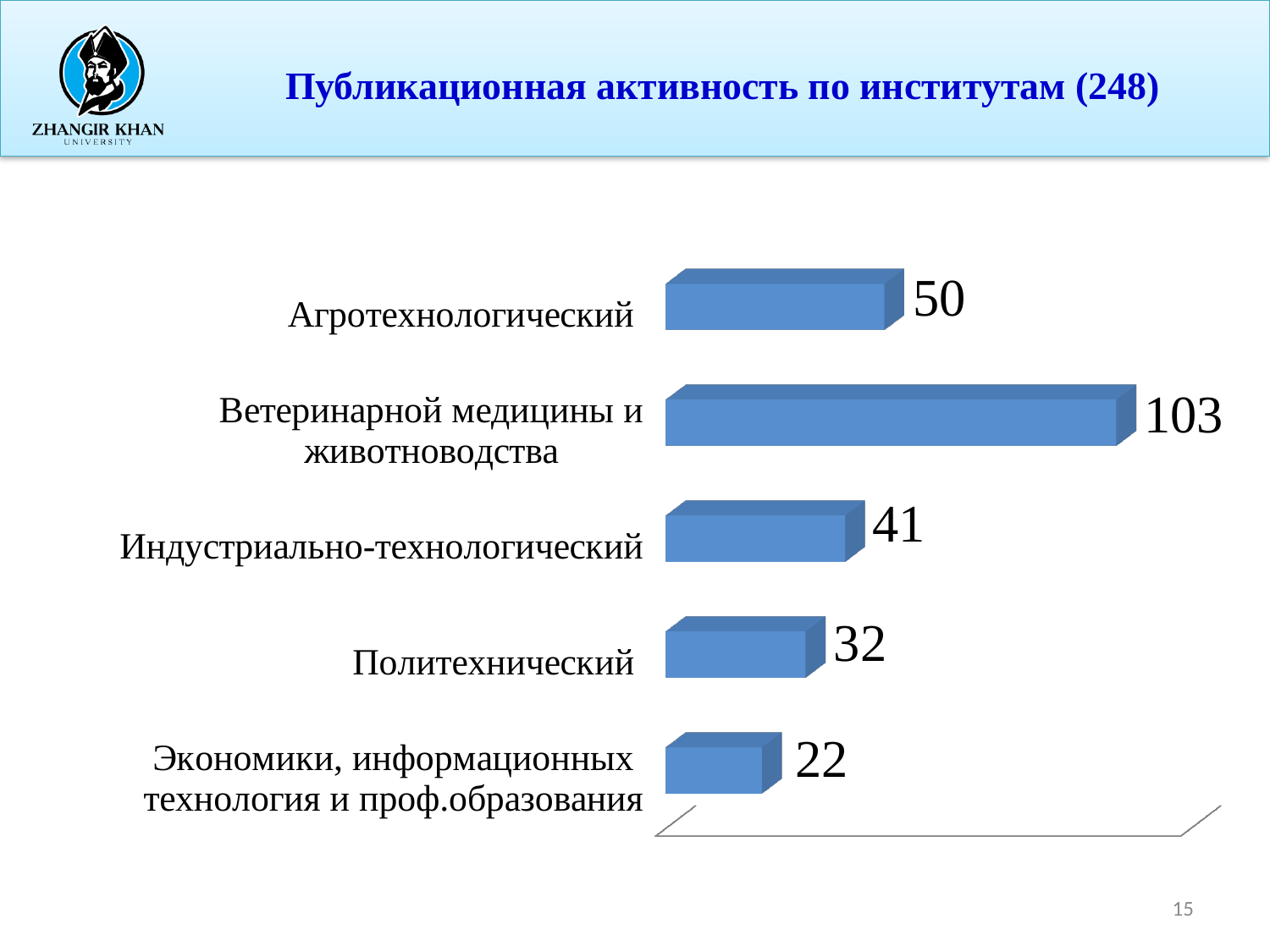
What is the title of the slide? Публикационная активность по институтам (248) What is the difference between the values for Ветеринарной медицины и животноводства and Агротехнологический? 53 What kind of chart is shown on the slide? Bar chart What is the value for Экономики, информационных технология и проф.образования? 22 How many institutes are shown in the chart? 5 What is the value for Политехнический? 32 Which institute has the lowest value? Экономики, информационных технология и проф.образования Which institute has the highest value? Ветеринарной медицины и животноводства What is the value for Агротехнологический? 50 What is the value for Индустриально-технологический? 41 Which is larger, the value for Индустриально-технологический or Политехнический? Индустриально-технологический What is the value for Ветеринарной медицины и животноводства? 103